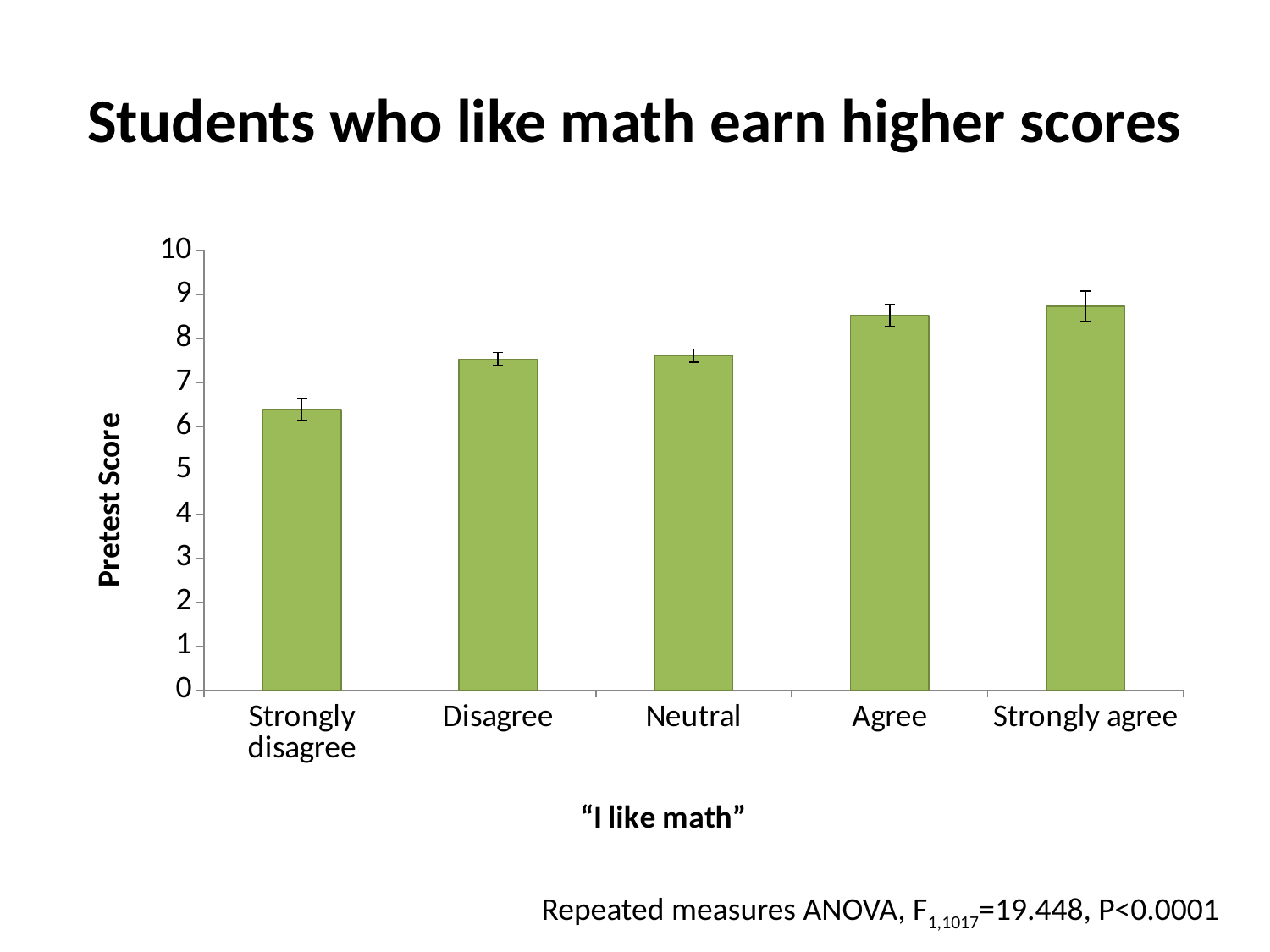
Is the pretest score for Strongly disagree greater or less than 7? less Do pretest scores generally rise or fall moving from Strongly disagree to Strongly agree? rise Is the pretest score for Strongly disagree greater or less than 6? greater What is the label on the vertical axis? Pretest Score Is the pretest score for Disagree greater or less than 7? greater Which has a higher pretest score, Strongly disagree or Agree? Agree What kind of chart is shown on the slide? bar chart Which category has the lowest pretest score? Strongly disagree Which category has the highest pretest score? Strongly agree How many response categories are shown on the x axis? 5